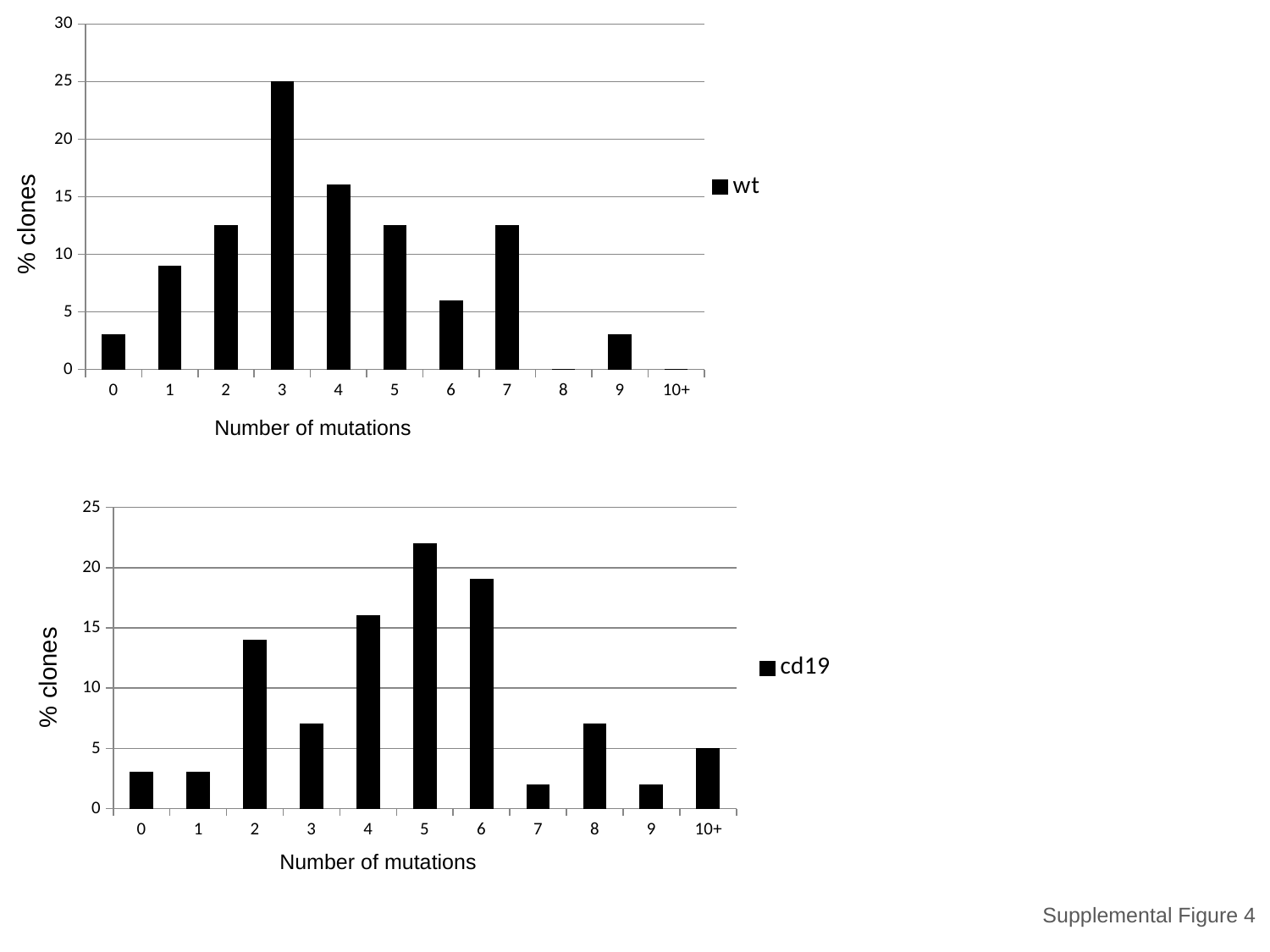
How many categories are shown on the x axis of the bottom chart? 11 What series name does the legend of the top chart show? wt In the top chart, which has the larger % clones: 3 mutations or 4 mutations? 3 mutations In the top chart, what is the % clones value for 3 mutations? 25 In the bottom chart, what is the % clones value for 10+ mutations? 5 What kind of chart is the top chart? bar chart In the bottom chart, which number of mutations has the highest % clones? 5 In the bottom chart, which has the larger % clones: 5 mutations or 6 mutations? 5 mutations In the bottom chart, is the value for 6 mutations greater or less than 15? greater In the top chart, which number of mutations has the highest % clones? 3 In the top chart, is the value for 1 mutation greater or less than 10? less In the top chart, is the value for 4 mutations greater or less than 15? greater